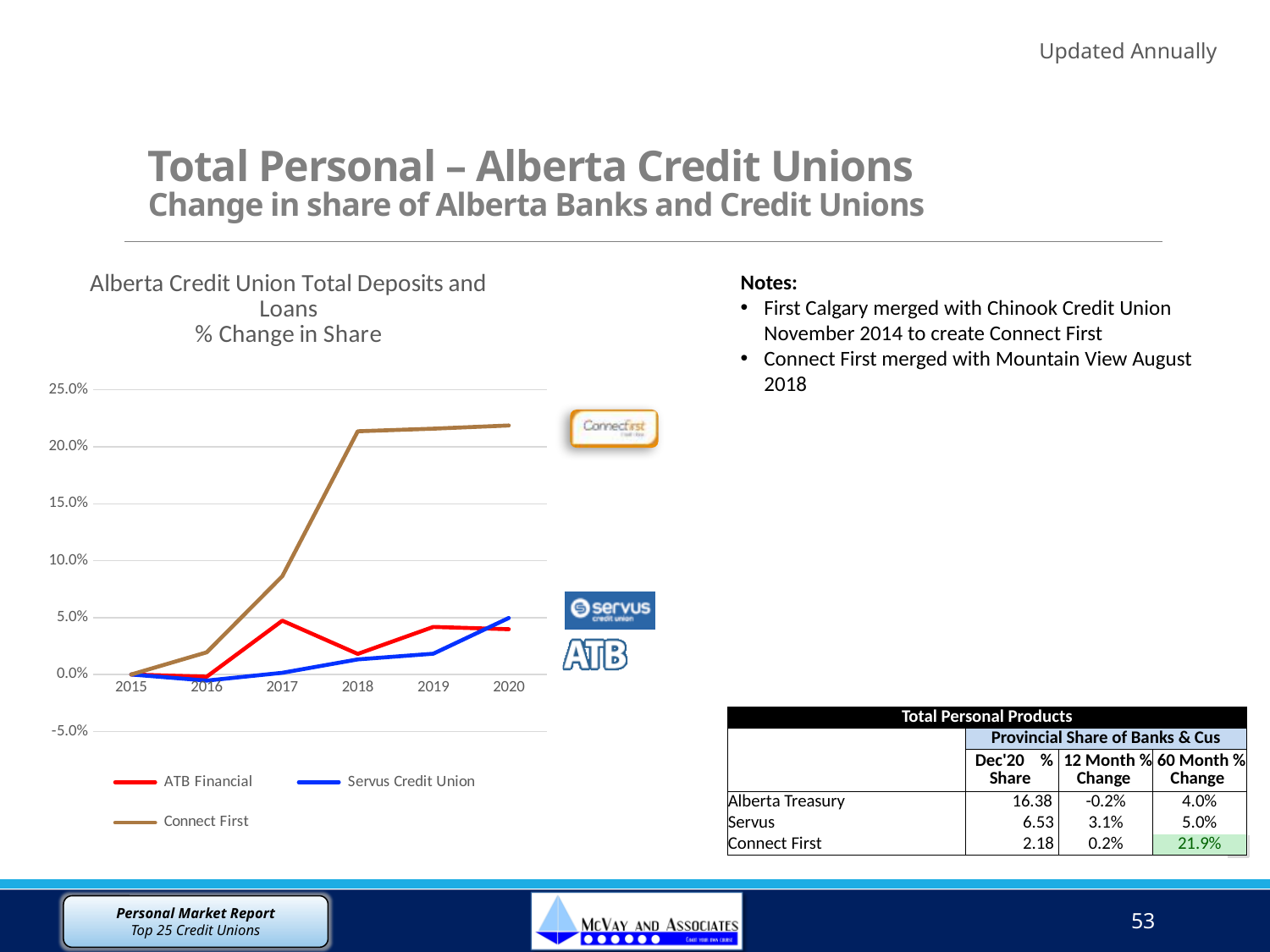
Which series has the highest value in 2020? Connect First Is the value for Servus Credit Union in 2019 greater or less than 5.0%? less How many series does the chart legend list? 3 What colour is the line for Servus Credit Union? blue Is the value for Connect First in 2017 greater or less than 5.0%? greater In 2019, which is larger: the value for Connect First or the value for ATB Financial? Connect First What is the value for Connect First in 2015? 0.0% How many years are shown on the x axis of the chart? 6 Does the Connect First line rise or fall from 2015 to 2020? rise What kind of chart is shown on the slide? line chart Is the value for ATB Financial in 2018 greater or less than 5.0%? less